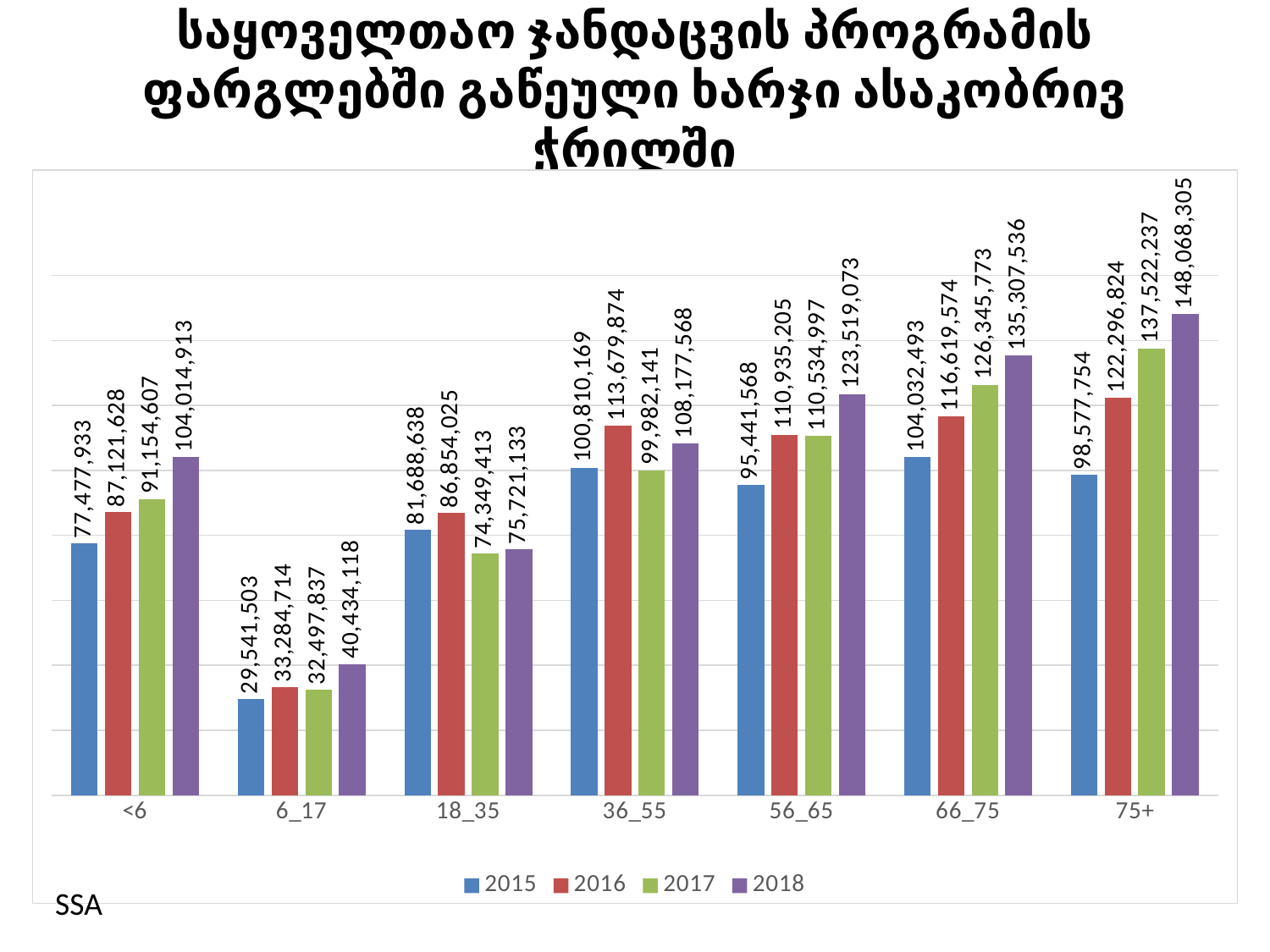
What kind of chart is shown on the slide? bar chart How many age groups are shown on the x axis? 7 Which age group has the highest value for 2018? 75+ What are the entries listed in the legend? 2015, 2016, 2017, 2018 What is the value for 2018 in the 75+ age group? 148,068,305 In the 36_55 age group, which is larger: the 2016 value or the 2018 value? 2016 Which age group has the lowest value for 2017? 6_17 What is the value for 2015 in the 6_17 age group? 29,541,503 How many series does the legend list? 4 What is the value for 2017 in the 66_75 age group? 126,345,773 For the 75+ age group, do the values rise or fall from 2015 to 2018? rise What is the difference between the 2018 and 2015 values for the <6 age group? 26,536,980